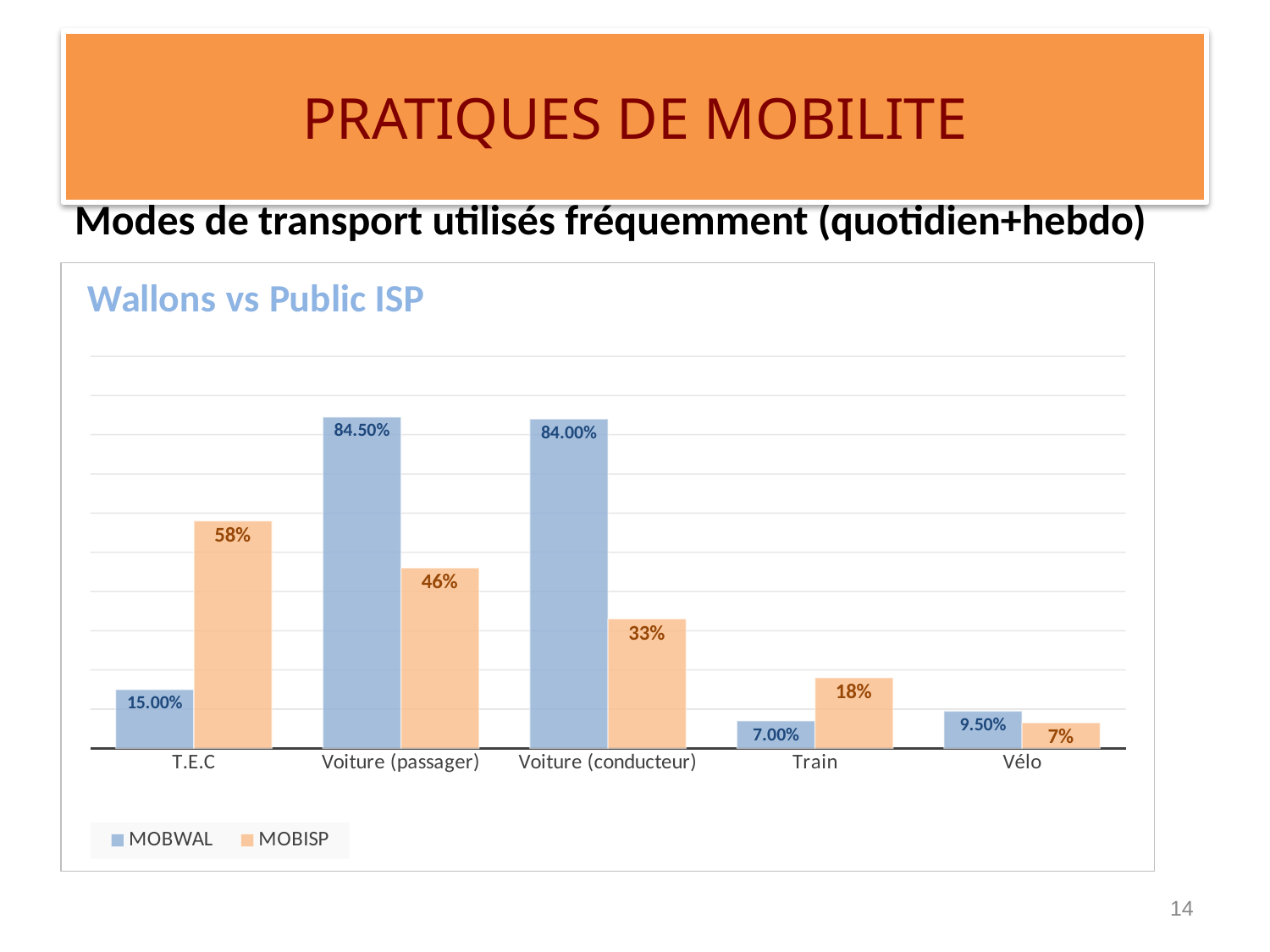
How many series does the legend list? 2 What is the MOBWAL value for Vélo? 9.50% Which category has the lowest MOBWAL value? Train What type of chart is shown on the slide? Bar chart What is the MOBISP value for T.E.C? 58% How many transport mode categories are shown on the x axis? 5 For Train, which series has the larger value, MOBWAL or MOBISP? MOBISP What is the MOBWAL value for Voiture (passager)? 84.50% Which category has the highest MOBISP value? T.E.C What is the MOBISP value for Train? 18% What is the difference between the MOBISP and MOBWAL values for T.E.C? 43 percentage points Which category has the lowest MOBISP value? Vélo